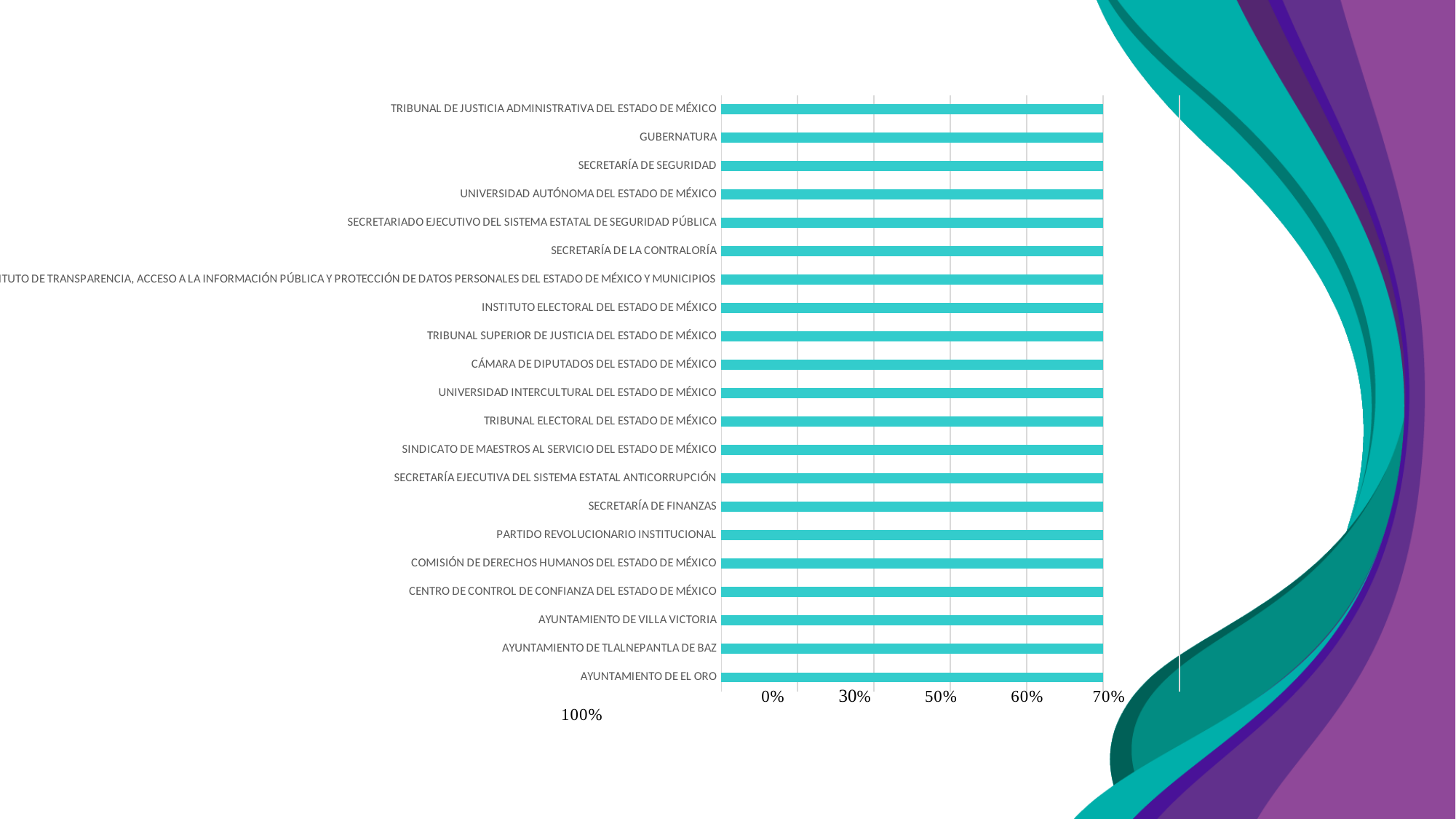
Which category is listed at the top of the chart? TRIBUNAL DE JUSTICIA ADMINISTRATIVA DEL ESTADO DE MÉXICO Is the value for PARTIDO REVOLUCIONARIO INSTITUCIONAL greater or less than 60%? greater How many categories (institutions) are plotted in the chart? 21 Is the value for GUBERNATURA greater or less than 60%? greater What colour are the bars in the chart? teal What kind of chart is shown on the slide? bar chart Is the value for CENTRO DE CONTROL DE CONFIANZA DEL ESTADO DE MÉXICO greater or less than 50%? greater